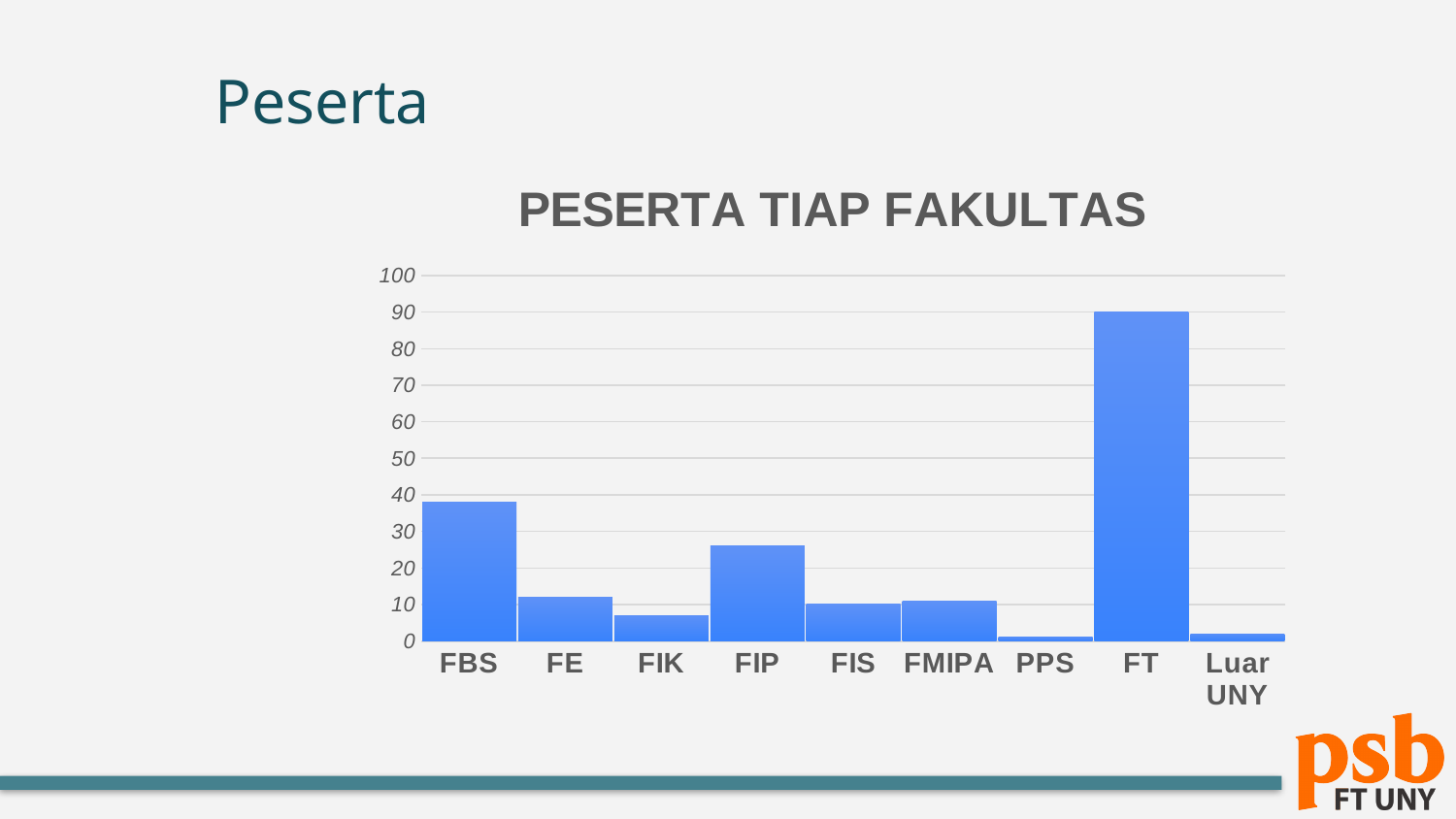
What kind of chart is shown on the slide? bar chart Is the value for FIK greater or less than 10? less What is the title of the chart? PESERTA TIAP FAKULTAS Is the value for PPS greater or less than 10? less What is the value for FT? 90 Which is larger, the value for FE or the value for FIK? FE Is the value for FE greater or less than 20? less Which category has the highest value in the chart? FT Which is larger, the value for FBS or the value for FIP? FBS How many categories are shown on the x axis of the chart? 9